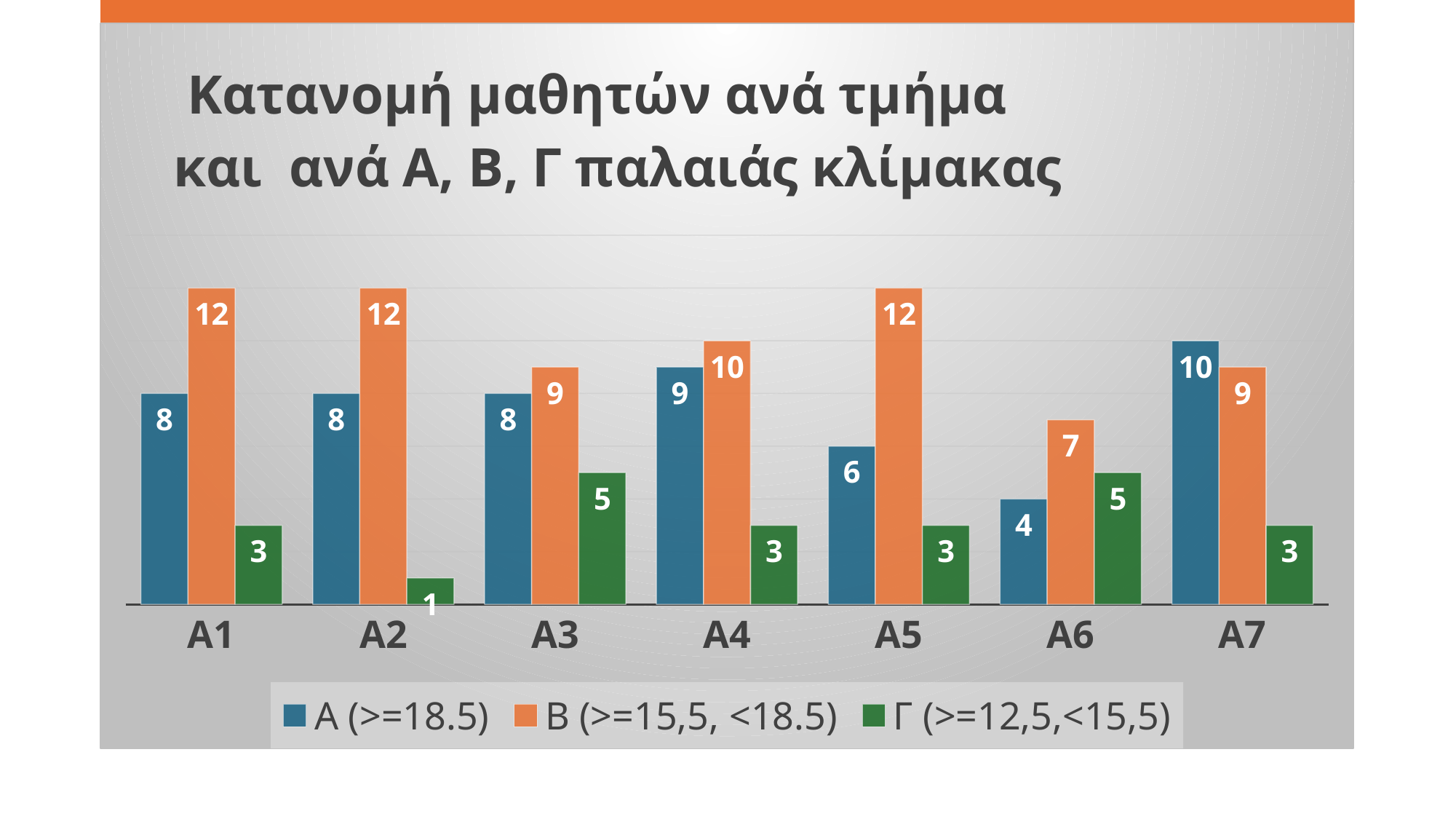
What is the value for series A (>=18.5) in category A4? 9 What is the value for series B (>=15,5, <18.5) in category A6? 7 Which category has the lowest value for series A (>=18.5)? A6 How many categories are shown on the x axis? 7 What is the difference between the B (>=15,5, <18.5) value and the A (>=18.5) value in category A1? 4 Which category has the highest value for series A (>=18.5)? A7 What is the total of the three series values in category A5? 21 What is the value for series Γ (>=12,5,<15,5) in category A2? 1 In category A7, which is larger: the A (>=18.5) value or the B (>=15,5, <18.5) value? A (>=18.5) How many series does the legend list? 3 What colour are the bars for series Γ (>=12,5,<15,5)? green What kind of chart is shown on the slide? bar chart